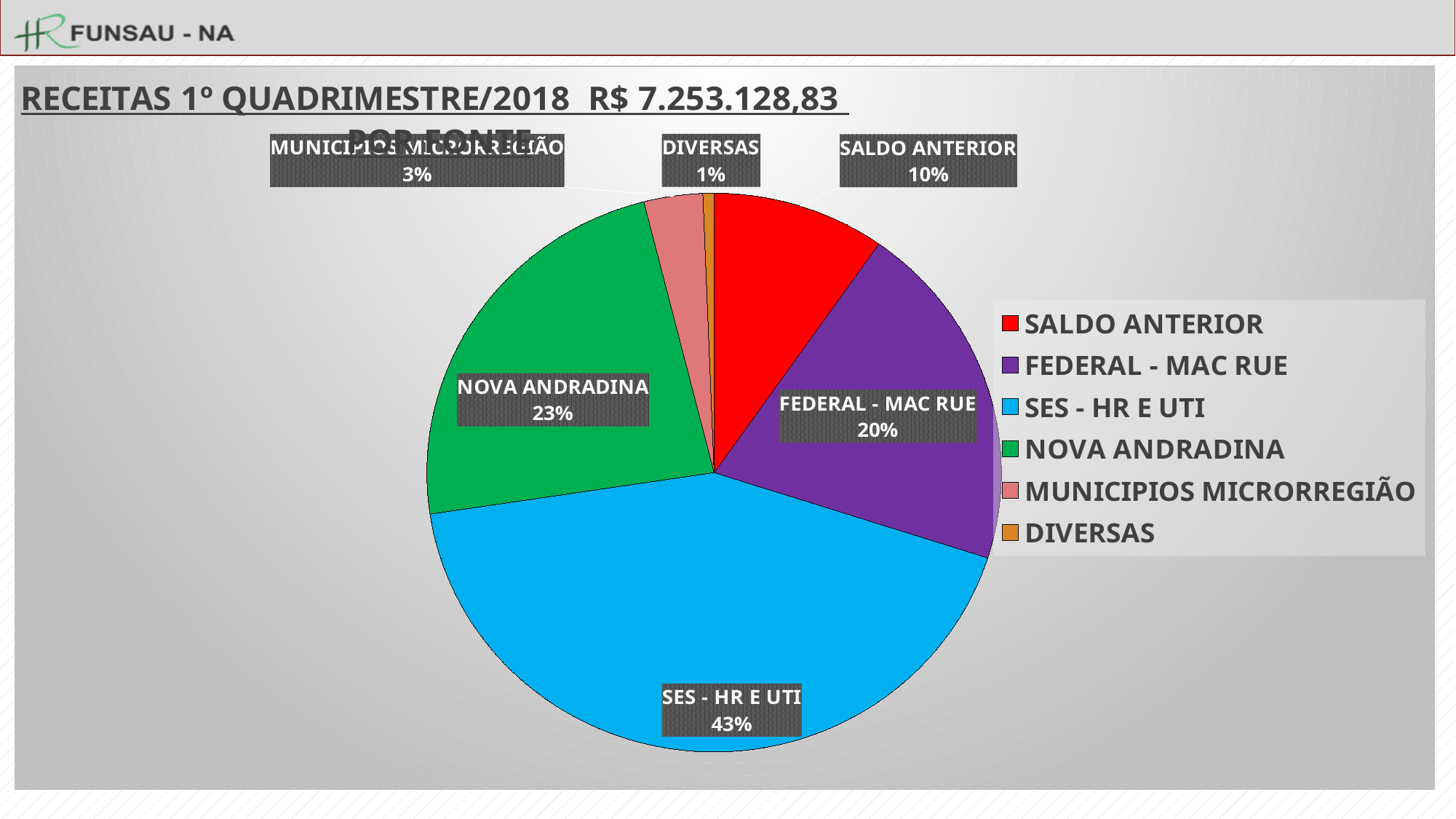
What is the difference in percentage points between SES - HR E UTI and NOVA ANDRADINA? 20 How many categories are shown in the pie chart? 6 What type of chart is shown on the slide? Pie chart Which category has the smallest slice of the pie? DIVERSAS What share of the pie does FEDERAL - MAC RUE represent? 20% Which is larger, the share for FEDERAL - MAC RUE or the share for SALDO ANTERIOR? FEDERAL - MAC RUE What share of the pie does MUNICIPIOS MICRORREGIÃO represent? 3% What share of the pie does SALDO ANTERIOR represent? 10% Which category has the largest slice of the pie? SES - HR E UTI